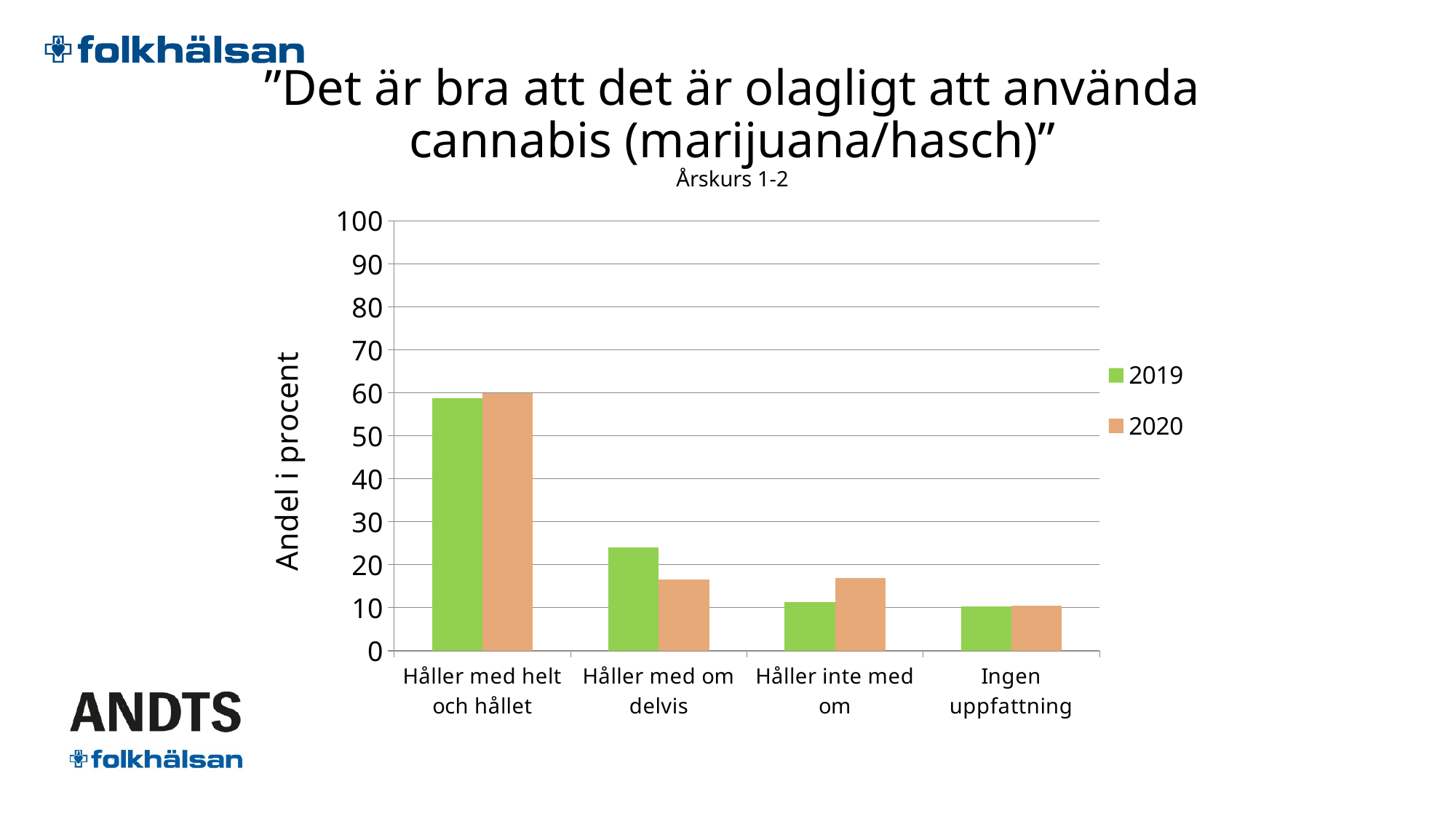
Is the 2020 value for 'Håller med om delvis' greater or less than 20? less Is the 2020 value for 'Håller inte med om' greater or less than 10? greater Which category has the highest value for the 2019 series? Håller med helt och hållet Is the 2019 value for 'Håller med helt och hållet' greater or less than 50? greater How many categories are shown on the x axis of the chart? 4 For 'Håller med om delvis', which series has the larger value, 2019 or 2020? 2019 How many series does the chart's legend list? 2 What kind of chart is shown on the slide? bar chart For 'Håller inte med om', which series has the larger value, 2019 or 2020? 2020 Which category has the lowest value for the 2020 series? Ingen uppfattning What is the title of the chart's vertical axis? Andel i procent